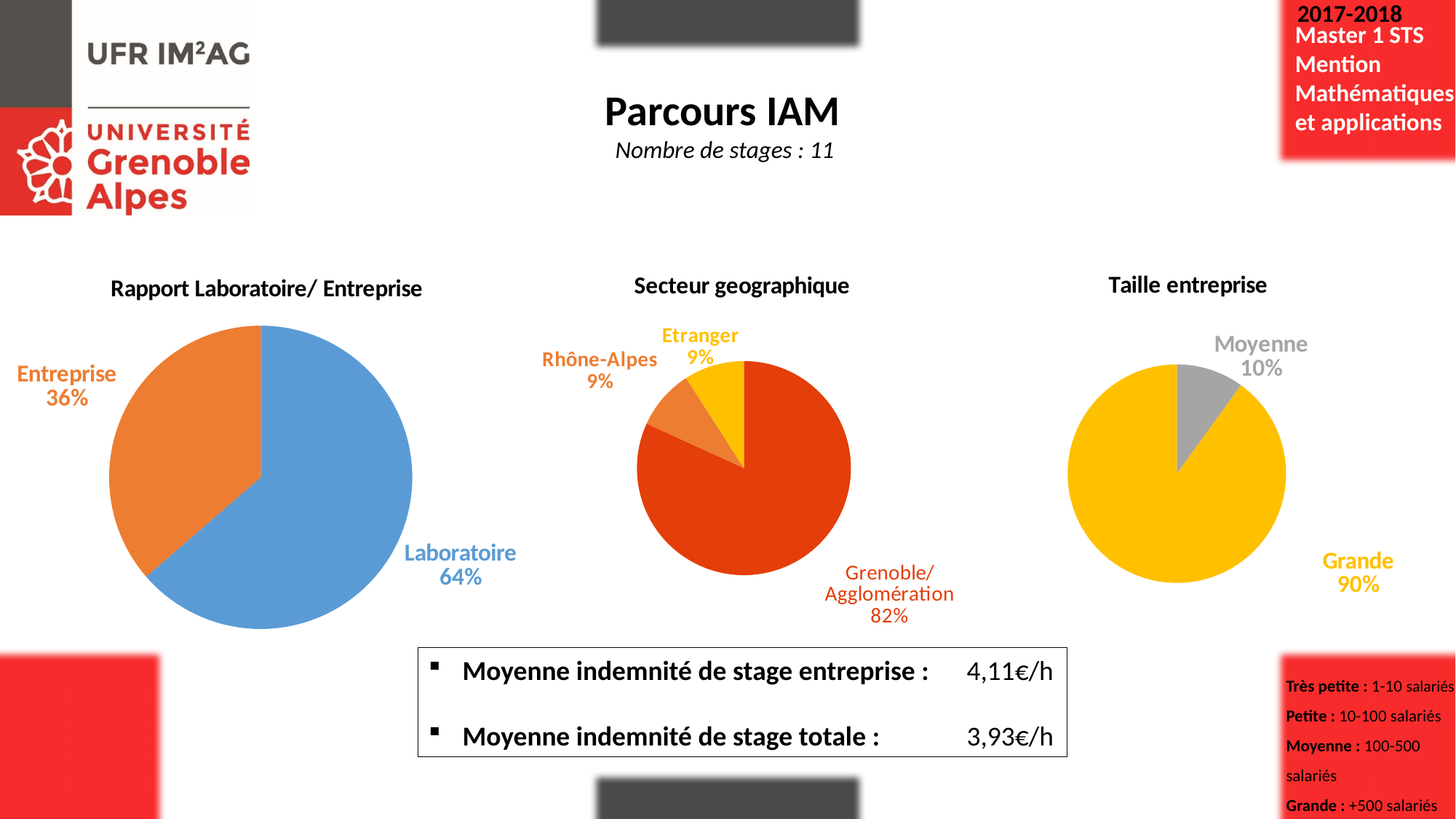
What type of chart is the 'Taille entreprise' chart? Pie chart In the 'Secteur geographique' chart, what share does Grenoble/Agglomération have? 82% In the 'Taille entreprise' chart, what share does Grande have? 90% In the 'Taille entreprise' chart, which category has the smallest share? Moyenne In the 'Rapport Laboratoire/ Entreprise' chart, what is the difference between the Laboratoire and Entreprise shares? 28% In the 'Rapport Laboratoire/ Entreprise' chart, which slice is larger, Laboratoire or Entreprise? Laboratoire In the 'Taille entreprise' chart, what share does Moyenne have? 10% How many categories are shown in the 'Secteur geographique' chart? 3 In the 'Secteur geographique' chart, which category has the largest share? Grenoble/Agglomération